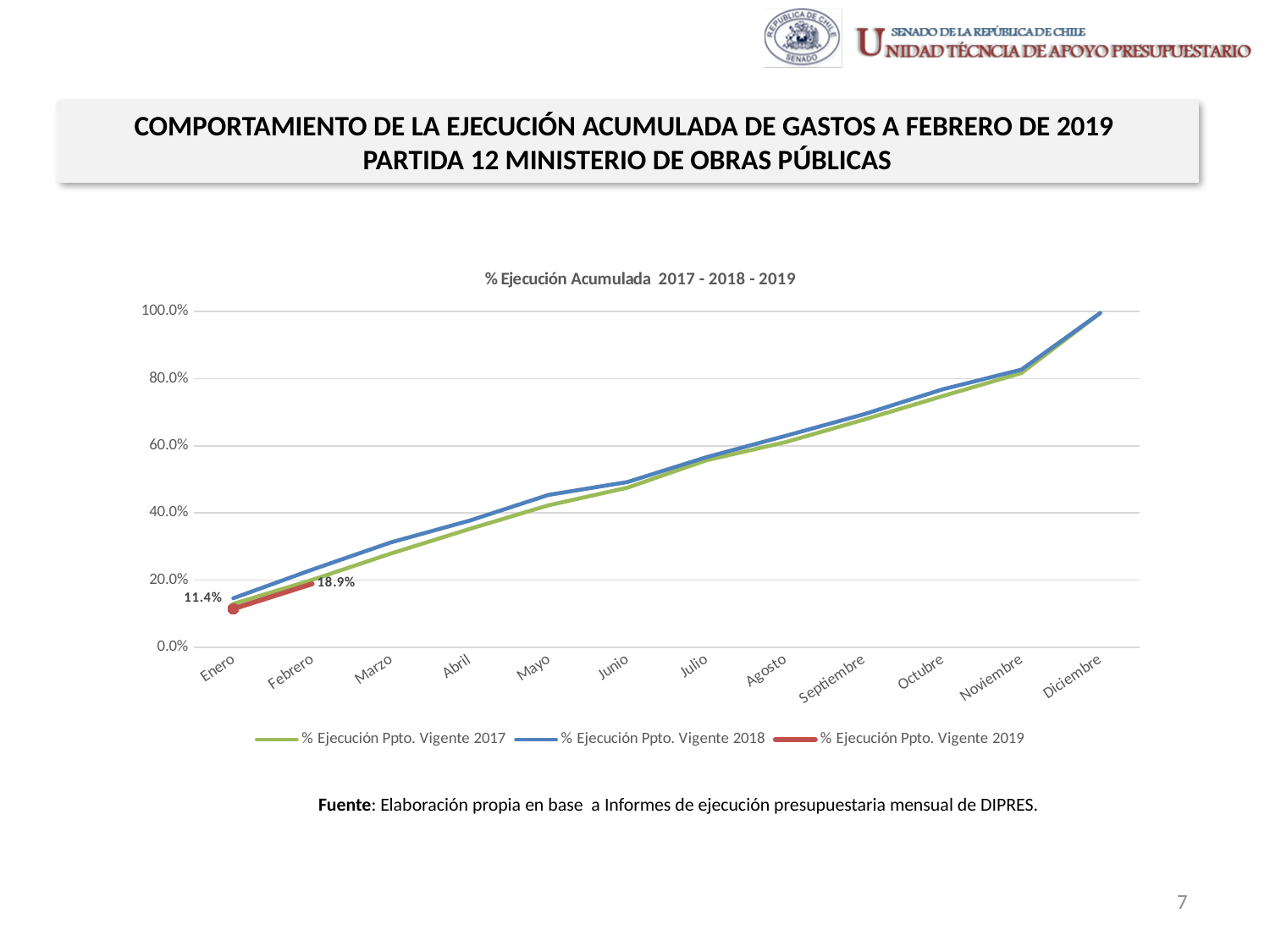
How many series does the legend list? 3 Is the value for Mayo in the % Ejecución Ppto. Vigente 2017 series greater or less than 60%? less In Mayo, which series has the higher value: % Ejecución Ppto. Vigente 2017 or % Ejecución Ppto. Vigente 2018? % Ejecución Ppto. Vigente 2018 What is the value for Febrero in the % Ejecución Ppto. Vigente 2019 series? 18.9% Is the value for Octubre in the % Ejecución Ppto. Vigente 2017 series greater or less than 60%? greater What kind of chart is shown on the slide? Line chart How many months are shown on the x axis? 12 What is the title of the chart? % Ejecución Acumulada 2017 - 2018 - 2019 By how many percentage points did the % Ejecución Ppto. Vigente 2019 series increase from Enero to Febrero? 7.5 percentage points Do the values of the % Ejecución Ppto. Vigente 2018 series rise or fall from Enero to Diciembre? Rise Is the value for Diciembre in the % Ejecución Ppto. Vigente 2018 series greater or less than 80%? greater What is the value for Enero in the % Ejecución Ppto. Vigente 2019 series? 11.4%